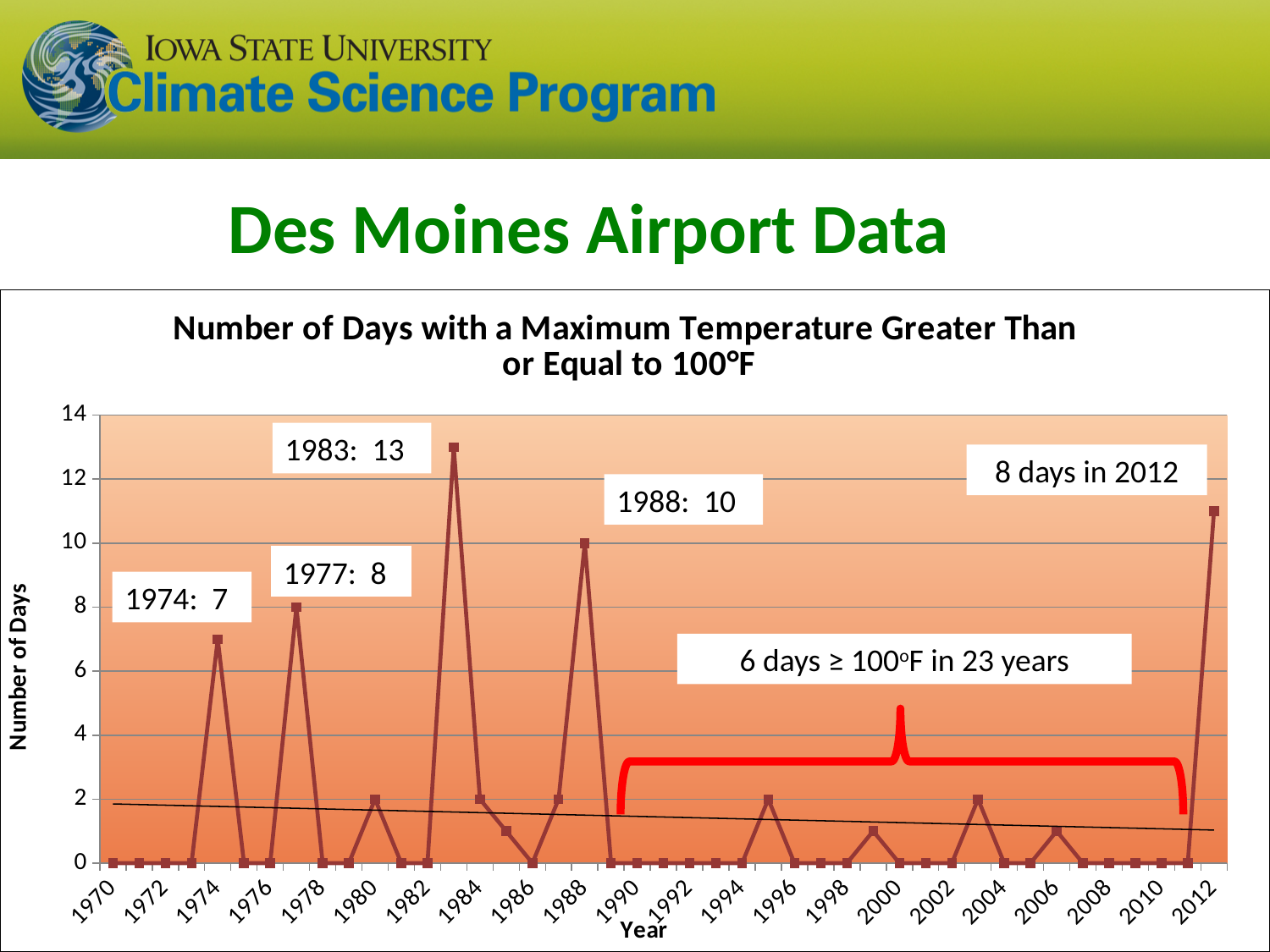
What is the label on the vertical axis? Number of Days Is the value plotted for 2012 greater or less than 10? greater How many days with a maximum temperature of at least 100°F were recorded in 1977? 8 What is the difference between the number of days in 1983 and the number of days in 1988? 3 Which year has the highest number of days with a maximum temperature of at least 100°F? 1983 How many days with a maximum temperature of at least 100°F were recorded in 1988? 10 Does the black trend line across the chart rise or fall from 1970 to 2012? fall What is the title of the chart? Number of Days with a Maximum Temperature Greater Than or Equal to 100°F Which year had more days with a maximum temperature of at least 100°F, 1974 or 1977? 1977 How many days with a maximum temperature of at least 100°F were recorded in 1983? 13 What type of chart is shown on the slide? line chart How many days with a maximum temperature of at least 100°F were recorded in 1974? 7